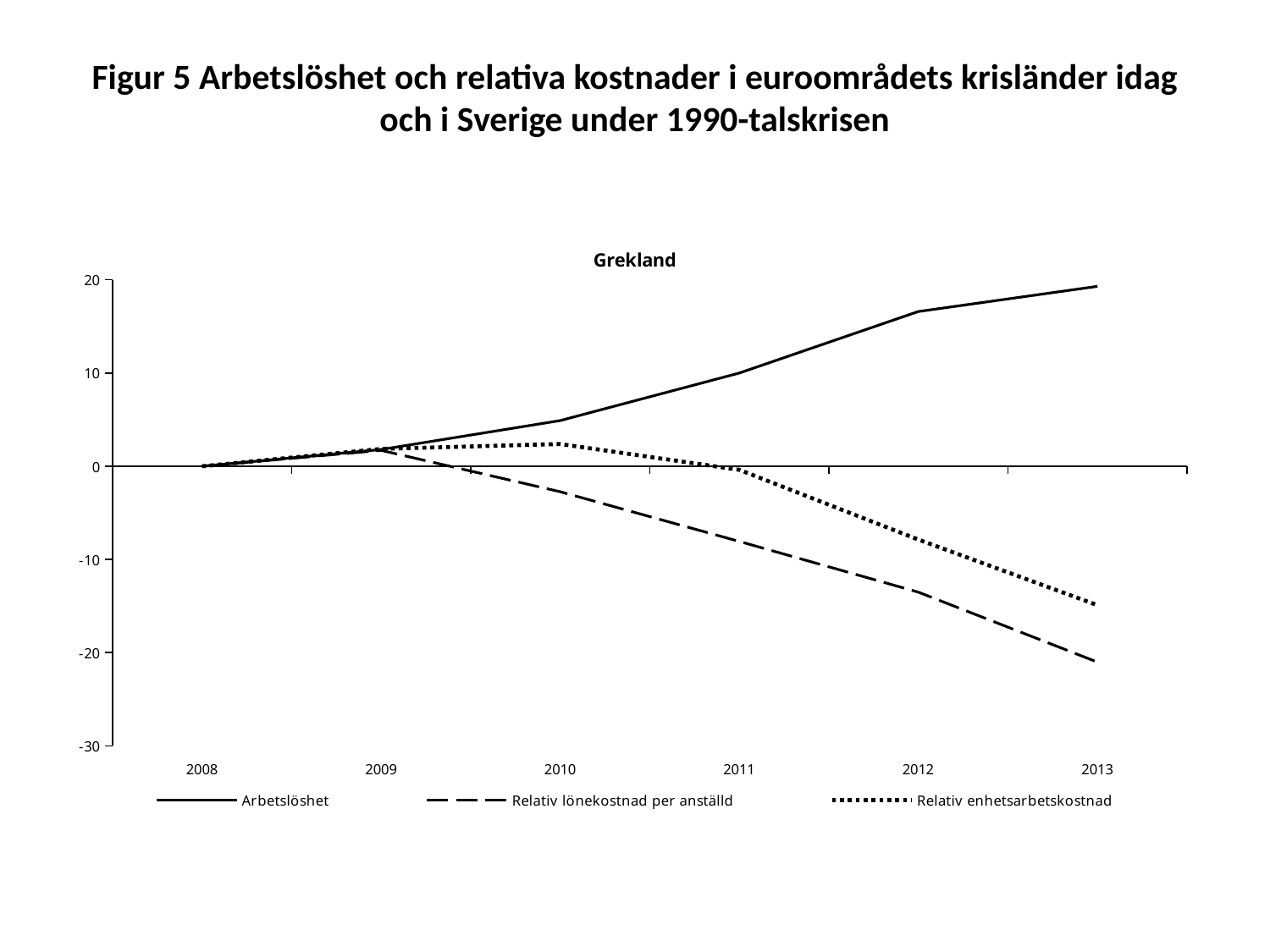
Is the value for Arbetslöshet in 2010 greater or less than 10? less Is the value for Arbetslöshet in 2013 greater or less than 10? greater What is the value of Arbetslöshet in 2008? 0 Which series is drawn with a dotted line? Relativ enhetsarbetskostnad What is the title printed above the plot area? Grekland How many years are shown on the x axis? 6 Is the value for Relativ lönekostnad per anställd in 2013 greater or less than -10? less Which series has the highest value in 2013? Arbetslöshet How many series does the legend list? 3 Which series has the lowest value in 2013? Relativ lönekostnad per anställd What kind of chart is shown on the slide? line chart